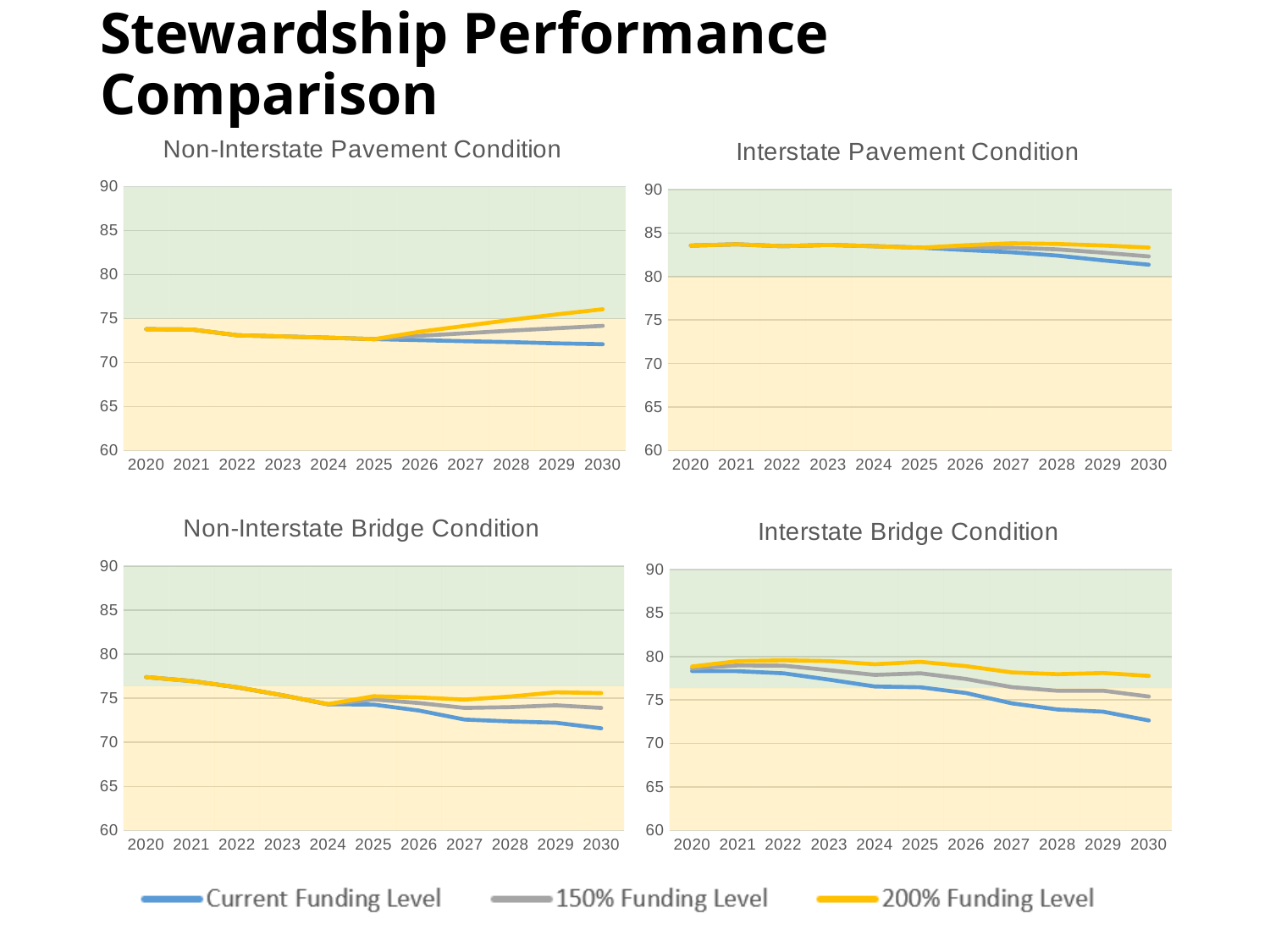
In the Non-Interstate Pavement Condition chart, is the value for 200% Funding Level in 2030 greater or less than 75? greater In the Interstate Pavement Condition chart, is the value for Current Funding Level in 2020 greater or less than 80? greater In the Non-Interstate Bridge Condition chart, which series has the highest value in 2030? 200% Funding Level How many charts are shown on the slide? 4 How many series does the legend at the bottom of the slide list? 3 How many years are shown on the x axis of the Interstate Bridge Condition chart? 11 In the Non-Interstate Pavement Condition chart, is the value for Current Funding Level in 2030 greater or less than 75? less What kind of chart is the Non-Interstate Pavement Condition chart? line chart In the Interstate Bridge Condition chart, does the Current Funding Level line rise or fall from 2020 to 2030? fall In the Interstate Bridge Condition chart, which series has the lowest value in 2030? Current Funding Level In the Interstate Pavement Condition chart, which is larger in 2030: Current Funding Level or 200% Funding Level? 200% Funding Level